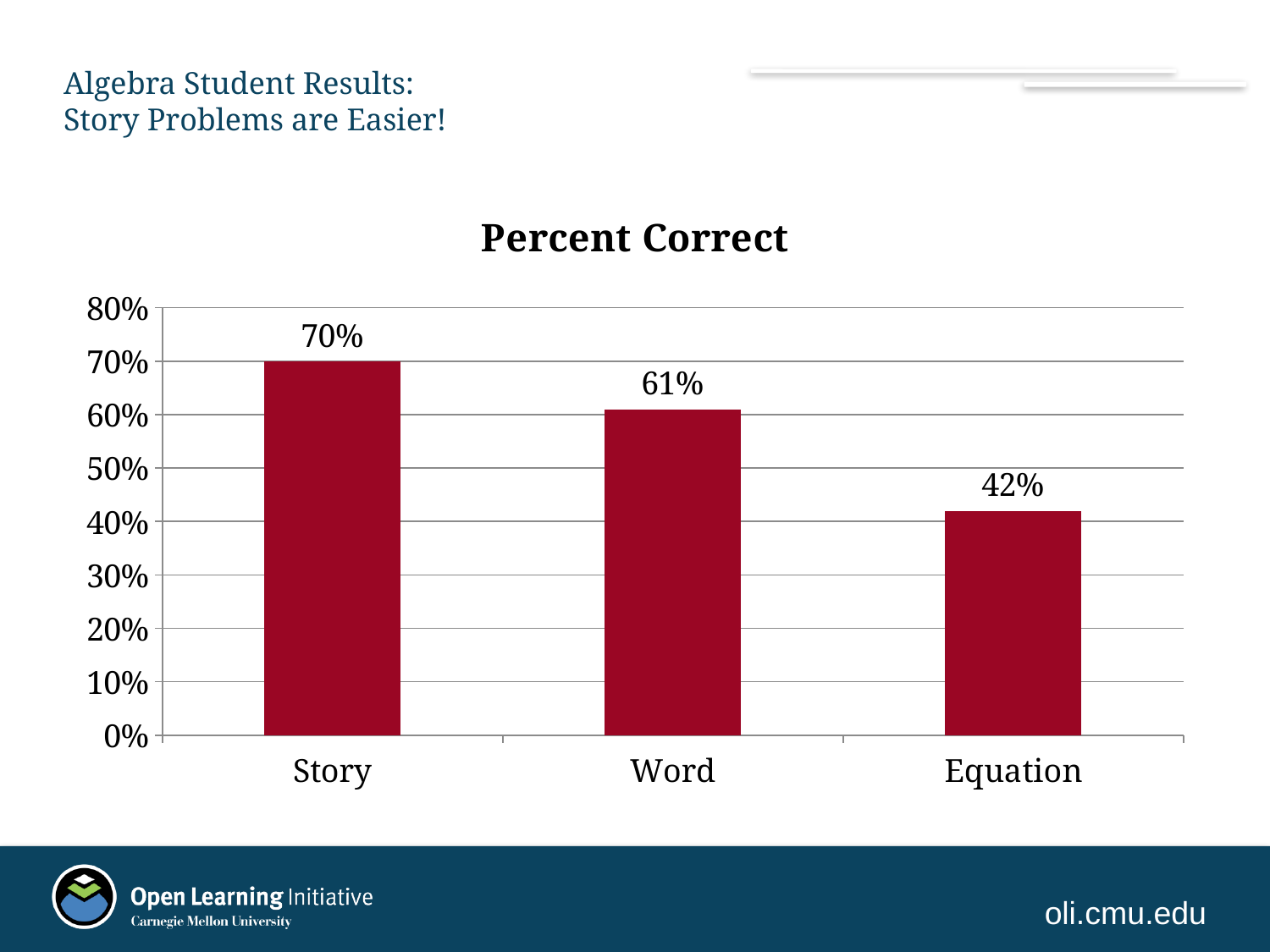
What kind of chart is shown on the slide? Bar chart What is the title of the chart? Percent Correct Which category has the lowest percent correct? Equation What is the percent correct for Story problems? 70% Which has a higher percent correct, Word or Equation? Word Which category has the highest percent correct? Story What is the percent correct for Word problems? 61% How many categories are shown in the chart? 3 What is the percent correct for Equation problems? 42% What is the difference in percent correct between Story and Equation? 28% What is the difference in percent correct between Story and Word? 9% Is the value for Equation greater or less than 50%? less